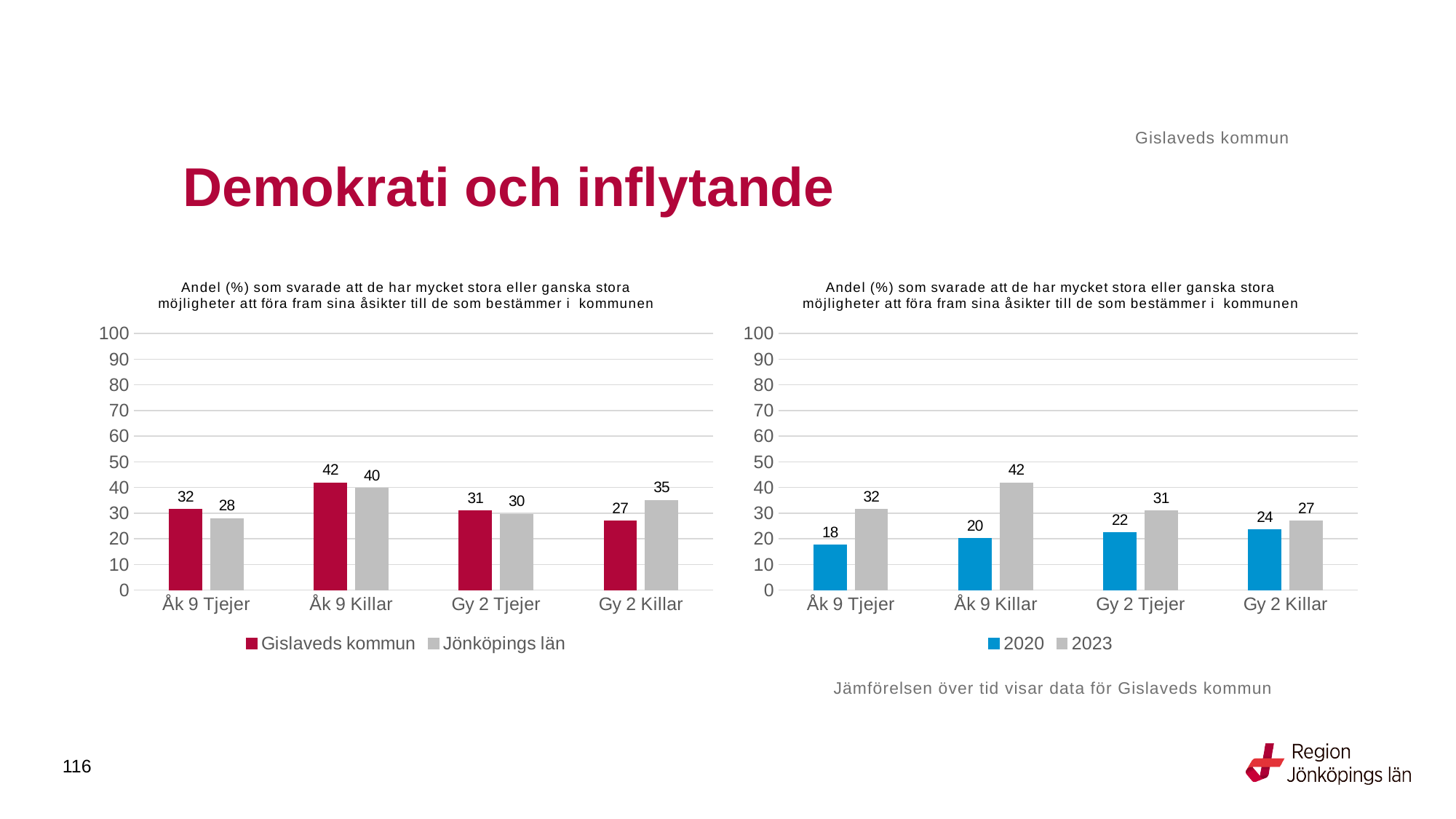
In the left chart, what is the value for Gislaveds kommun for Åk 9 Killar? 42 In the right chart, do the 2020 values rise or fall from Åk 9 Tjejer to Gy 2 Killar? rise In the right chart, what is the difference between 2023 and 2020 for Åk 9 Killar? 22 In the left chart, what is the difference between Gislaveds kommun and Jönköpings län for Gy 2 Killar? 8 In the left chart, which is larger for Åk 9 Tjejer: Gislaveds kommun or Jönköpings län? Gislaveds kommun What kind of chart is the left chart? bar chart How many series does the legend of the right chart list? 2 In the left chart, which category has the highest value for Gislaveds kommun? Åk 9 Killar In the left chart, what is the value for Jönköpings län for Gy 2 Killar? 35 In the right chart, what is the value for 2020 for Åk 9 Tjejer? 18 In the right chart, what is the value for 2023 for Gy 2 Tjejer? 31 In the left chart, which category has the lowest value for Jönköpings län? Åk 9 Tjejer